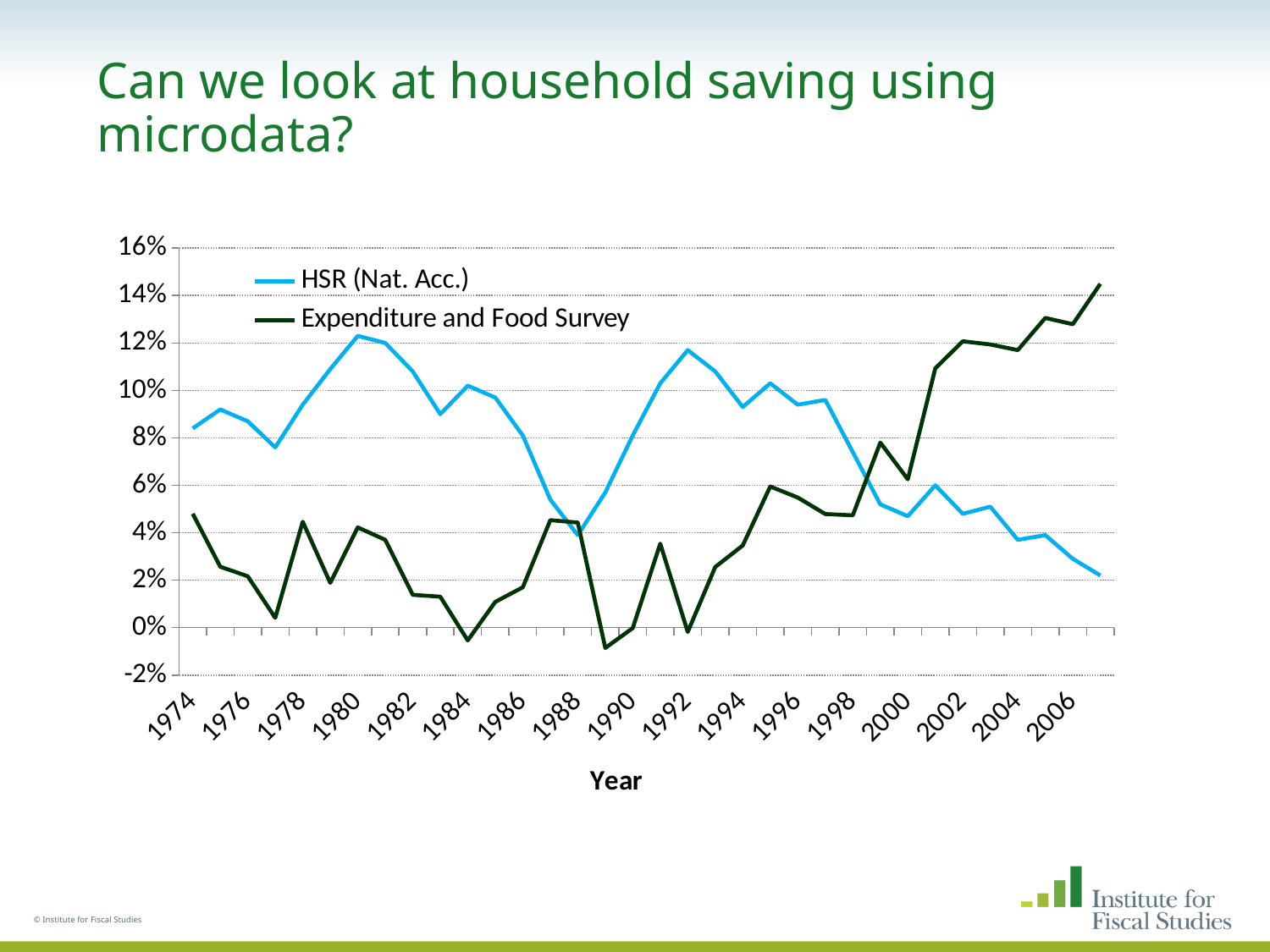
Is the Expenditure and Food Survey value for 1990 greater or less than 2%? less What are the two series named in the legend? HSR (Nat. Acc.) and Expenditure and Food Survey What kind of chart is shown on the slide? Line chart Is the HSR (Nat. Acc.) value for 2006 greater or less than 4%? less Is the HSR (Nat. Acc.) value for 1980 greater or less than 10%? greater What is the title of the x axis? Year Does the HSR (Nat. Acc.) series rise or fall between 1998 and 2006? Fall How many series does the legend list? 2 Does the Expenditure and Food Survey series rise or fall between 1998 and 2006? Rise In 2004, which series has the higher value, HSR (Nat. Acc.) or Expenditure and Food Survey? Expenditure and Food Survey In 1980, which series has the higher value, HSR (Nat. Acc.) or Expenditure and Food Survey? HSR (Nat. Acc.)